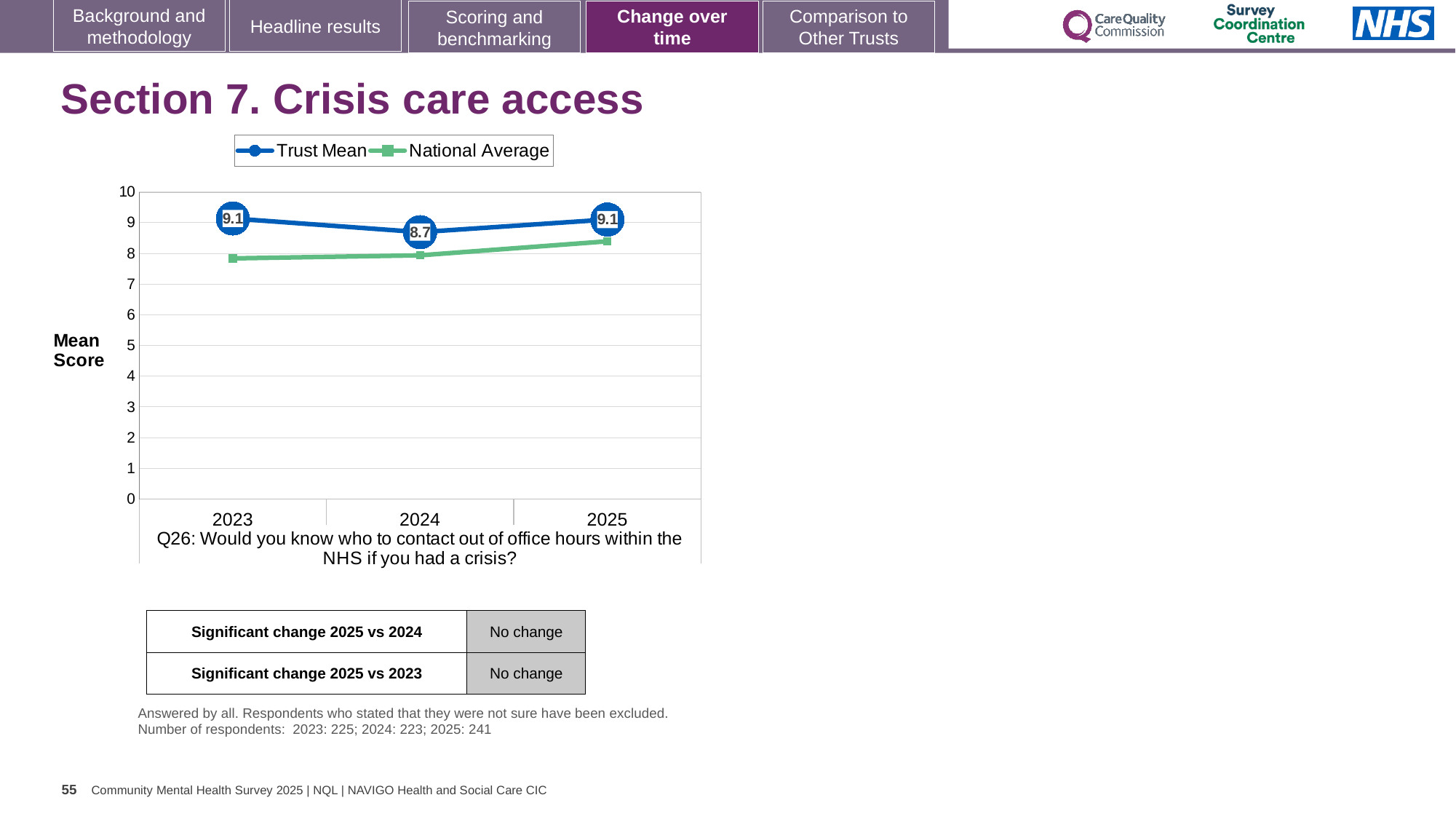
Is the National Average for 2025 greater or less than 8? greater Which is larger in 2024, the Trust Mean or the National Average? Trust Mean How many years are plotted on the x axis? 3 What is the difference between the Trust Mean in 2023 and 2024? 0.4 Is the National Average for 2023 greater or less than 8? less How many series does the legend list? 2 What is the Trust Mean score for 2025? 9.1 Which is larger, the Trust Mean in 2024 or the Trust Mean in 2025? 2025 What kind of chart is shown on the slide? line chart What is the Trust Mean score for 2024? 8.7 What is the Trust Mean score for 2023? 9.1 In which year is the Trust Mean lowest? 2024